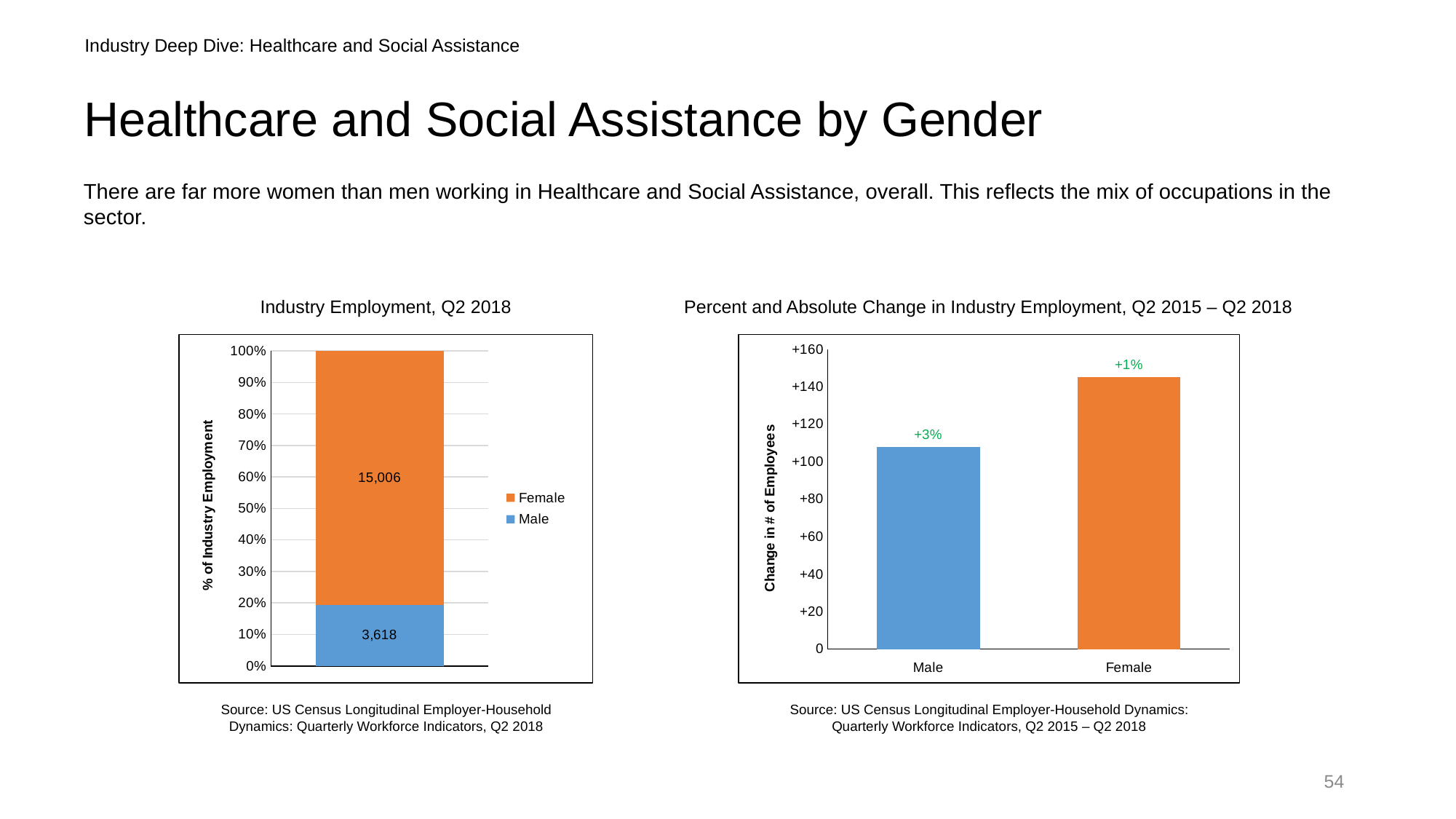
In the 'Industry Employment, Q2 2018' chart, which series has the larger value, Female or Male? Female In the 'Industry Employment, Q2 2018' chart, what is the value shown for Female? 15,006 In the 'Industry Employment, Q2 2018' chart, what is the total of the stacked bar? 18,624 In the 'Percent and Absolute Change in Industry Employment, Q2 2015 – Q2 2018' chart, is the change in number of employees for Female greater or less than +140? greater In the 'Industry Employment, Q2 2018' chart, what is the difference between the Female and Male values? 11,388 In the 'Percent and Absolute Change in Industry Employment, Q2 2015 – Q2 2018' chart, which category has the taller bar? Female How many series does the legend of the 'Industry Employment, Q2 2018' chart list? 2 In the 'Percent and Absolute Change in Industry Employment, Q2 2015 – Q2 2018' chart, is the change in number of employees for Male greater or less than +120? less In the 'Industry Employment, Q2 2018' chart, which colour represents Male? Blue In the 'Percent and Absolute Change in Industry Employment, Q2 2015 – Q2 2018' chart, what percent change is labelled for Male? +3% In the 'Industry Employment, Q2 2018' chart, what is the value shown for Male? 3,618 In the 'Percent and Absolute Change in Industry Employment, Q2 2015 – Q2 2018' chart, what percent change is labelled for Female? +1%